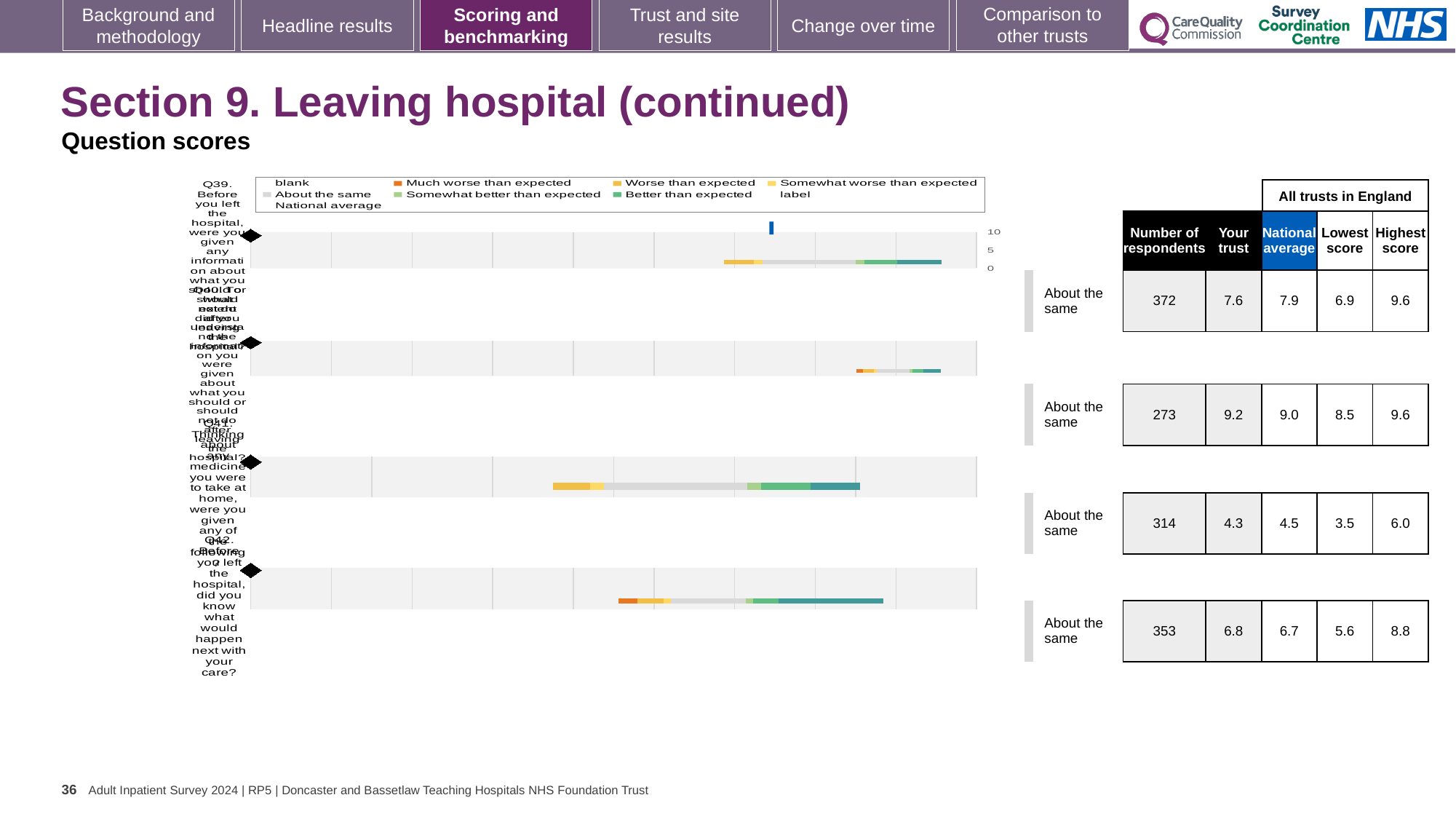
In the table beside the chart, what is the 'National average' in the second row? 9.0 In the table beside the chart, what is the 'Your trust' score in the first row? 7.6 In the table beside the chart, which row has the lowest 'Your trust' score? the third row (4.3) In the table beside the chart, what is the 'Number of respondents' in the third row? 314 In the table beside the chart, is the 'Your trust' score in the second row larger or smaller than the 'National average' in that row? larger What colour does the legend use for 'Much worse than expected'? orange In the table beside the chart, what is the 'Highest score' in the last row? 8.8 In the table beside the chart, what is the difference between the 'Highest score' and 'Lowest score' in the first row? 2.7 In the table beside the chart, what benchmark label is given for every row? About the same What kind of chart is shown on the slide? bar chart What is the highest value shown on the chart's numeric axis? 10 How many horizontal bars are plotted on the chart? 4